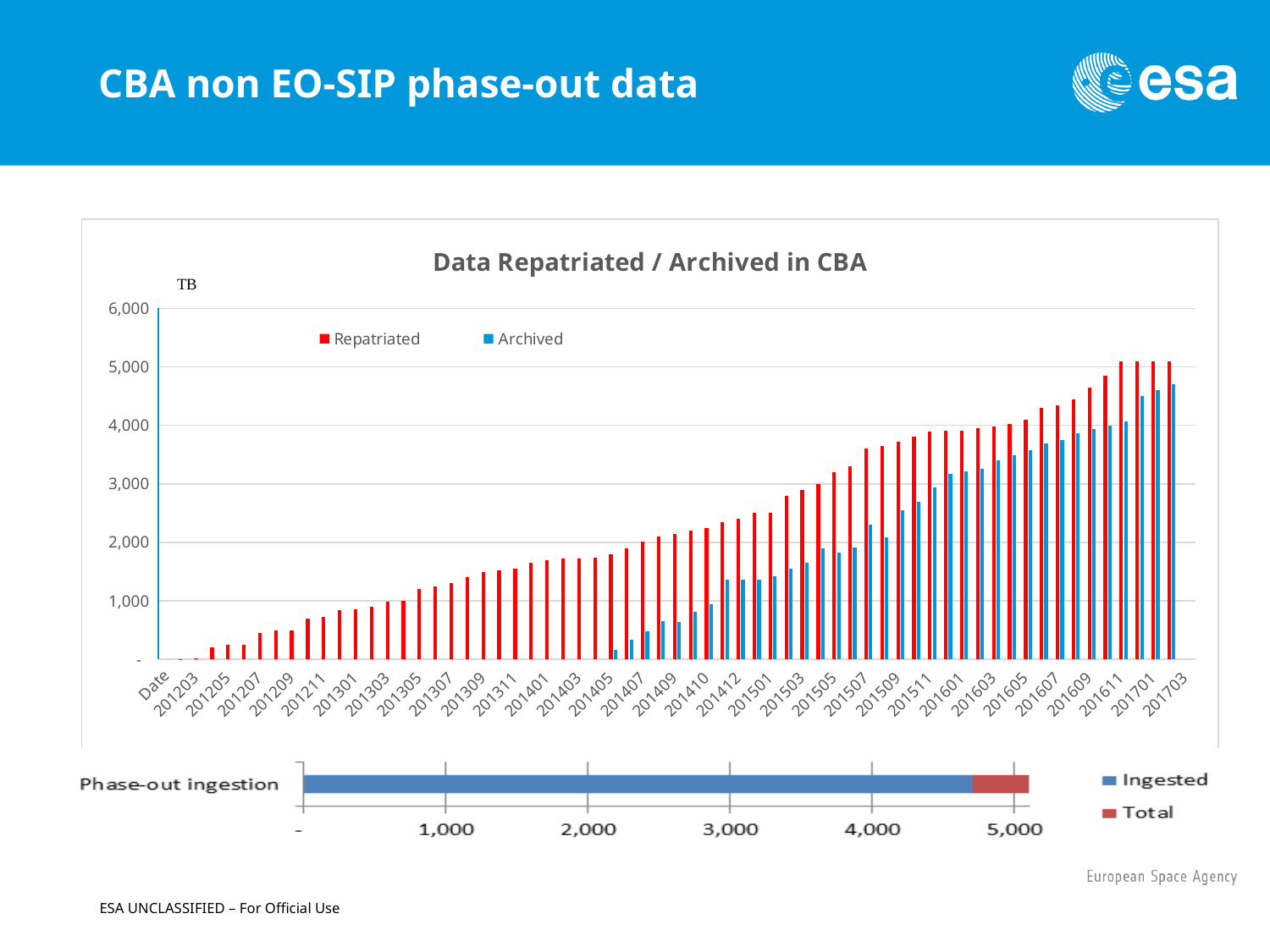
In the chart titled "Data Repatriated / Archived in CBA", is the Repatriated value for 201211 greater or less than 1,000? less In the chart titled "Data Repatriated / Archived in CBA", how many series does the legend list? 2 In the chart titled "Data Repatriated / Archived in CBA", what unit is shown at the top of the vertical axis? TB In the chart titled "Data Repatriated / Archived in CBA", do the Repatriated values rise or fall from 201203 to 201703? Rise In the chart titled "Data Repatriated / Archived in CBA", which is larger for 201507, the Repatriated value or the Archived value? Repatriated In the "Phase-out ingestion" chart at the bottom of the slide, how many series does the legend list? 2 In the chart titled "Data Repatriated / Archived in CBA", what are the two series named in the legend? Repatriated and Archived In the chart titled "Data Repatriated / Archived in CBA", is the Archived value for 201605 greater or less than 3,000? greater In the "Phase-out ingestion" chart at the bottom of the slide, is the Ingested value greater or less than 4,000? greater In the chart titled "Data Repatriated / Archived in CBA", what kind of chart is used? Bar chart